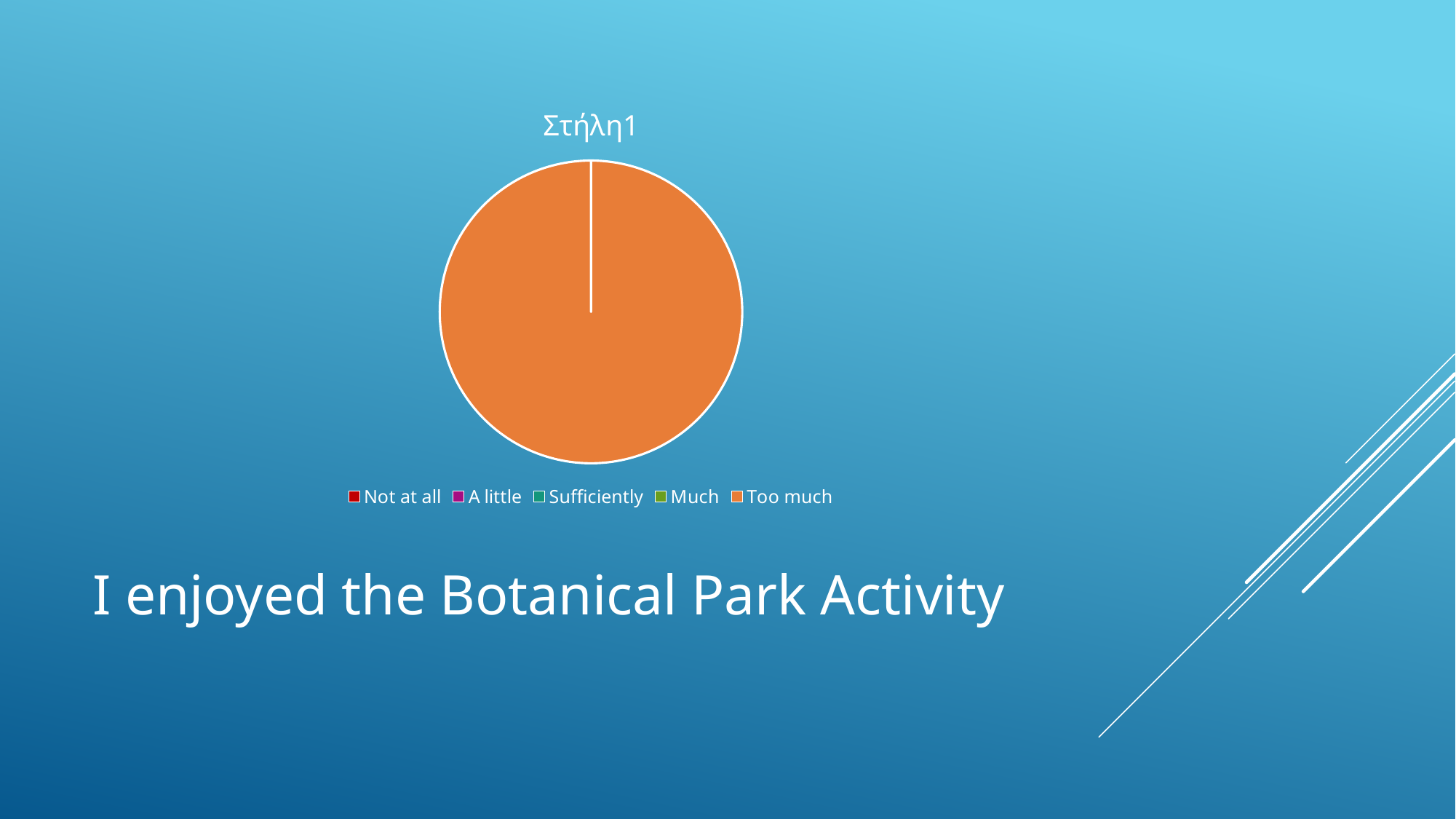
Which legend entry is listed last? Too much Which category is larger in the pie, "Much" or "Too much"? Too much Which legend entry is listed first? Not at all What colour is the slice for "Too much"? orange Which category is larger in the pie, "A little" or "Too much"? Too much Which category is larger in the pie, "Too much" or "Not at all"? Too much How many categories does the chart's legend list? 5 What kind of chart is shown on the slide? pie chart Which category accounts for the largest slice of the pie? Too much